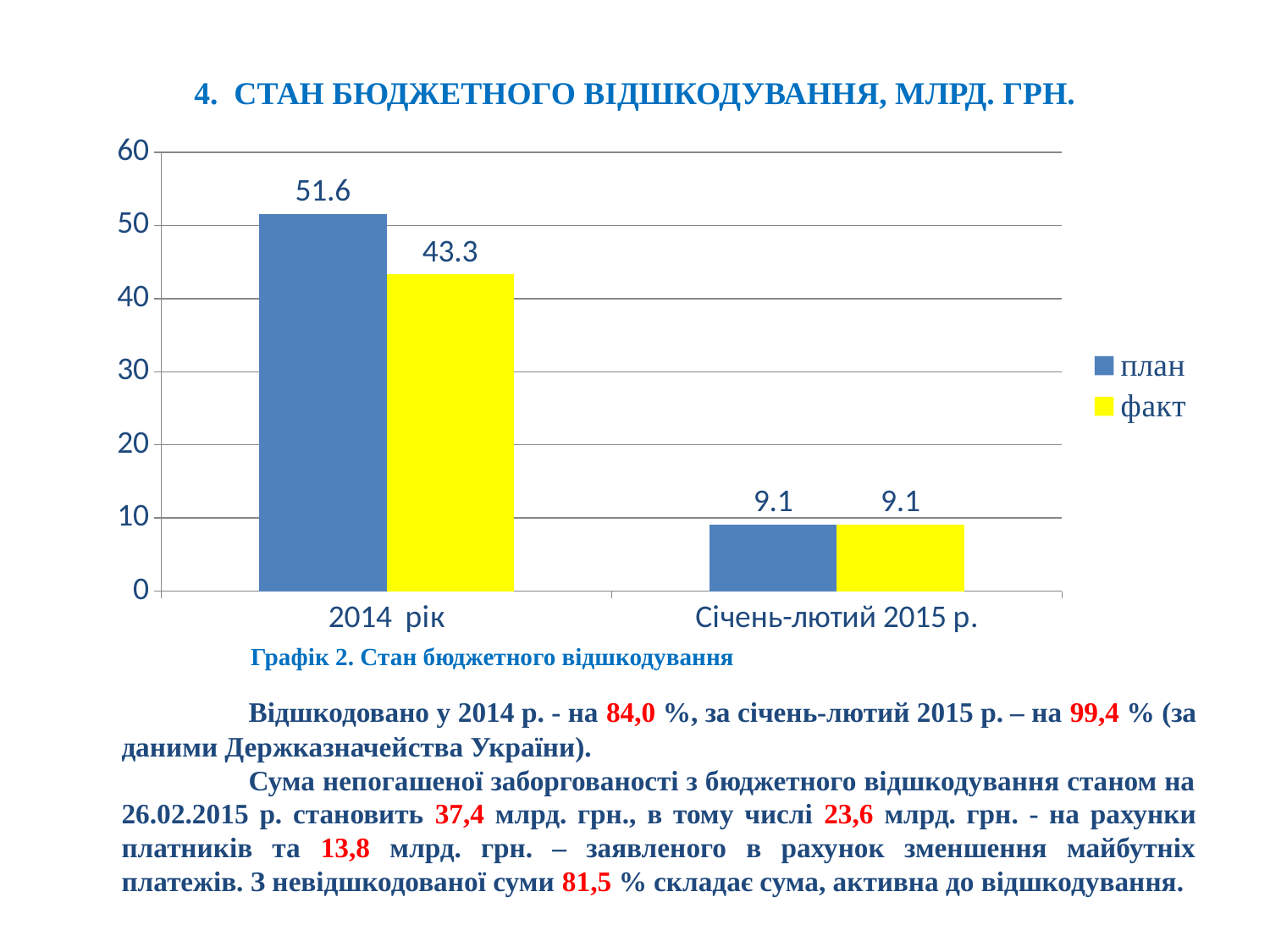
What kind of chart is shown on the slide? bar chart How many categories are shown on the x axis? 2 What is the value of "план" for "2014 рік"? 51.6 What is the value of "факт" for "2014 рік"? 43.3 For "2014 рік", which is larger: "план" or "факт"? план How many series does the legend list? 2 What is the value of "план" for "Січень-лютий 2015 р."? 9.1 What is the difference between "план" and "факт" for "2014 рік"? 8.3 What is the value of "факт" for "Січень-лютий 2015 р."? 9.1 Which category has the lowest "факт" value? Січень-лютий 2015 р. Which colour represents the "факт" series? yellow Which category has the highest "план" value? 2014 рік